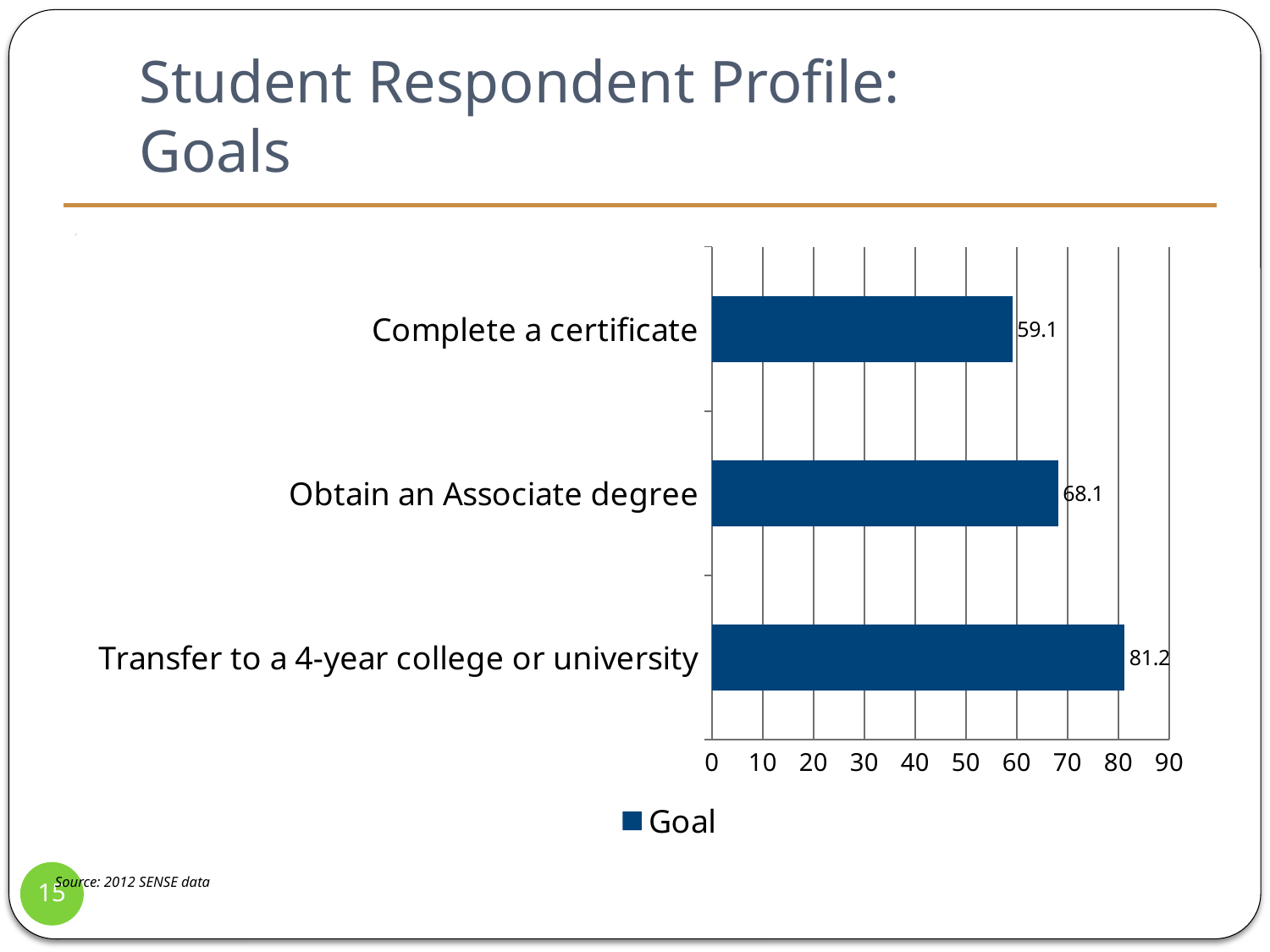
What is the value for "Transfer to a 4-year college or university"? 81.2 Which goal has the highest value? Transfer to a 4-year college or university What is the difference between the values for "Obtain an Associate degree" and "Complete a certificate"? 9.0 Which goal has the lowest value? Complete a certificate Is the value for "Obtain an Associate degree" greater or less than 70? less What is the difference between the values for "Transfer to a 4-year college or university" and "Complete a certificate"? 22.1 What is the value for "Obtain an Associate degree"? 68.1 How many goal categories are shown in the chart? 3 How many series does the legend list? 1 What is the value for "Complete a certificate"? 59.1 What kind of chart is shown on the slide? Bar chart Which is larger: the value for "Obtain an Associate degree" or the value for "Complete a certificate"? Obtain an Associate degree